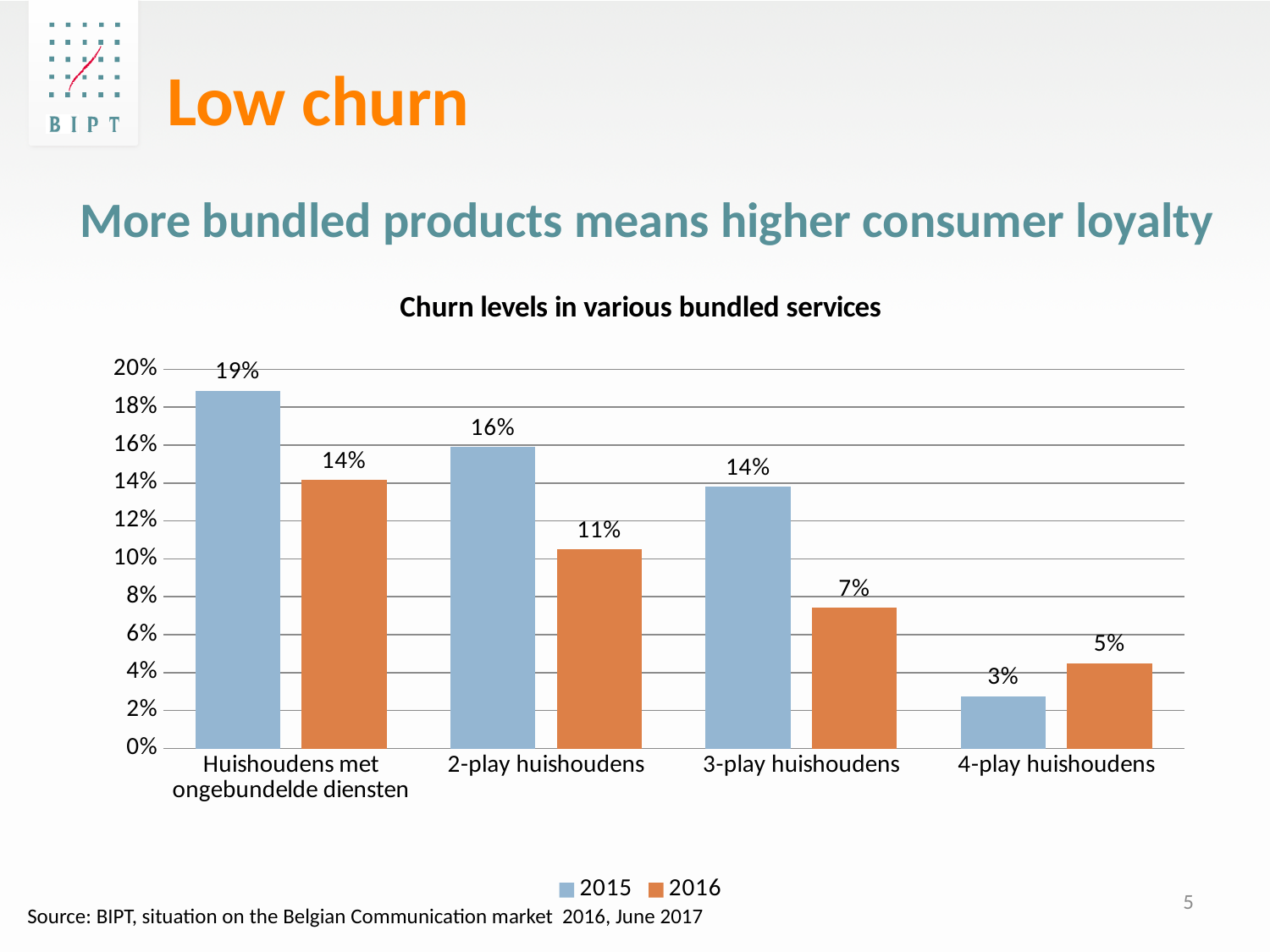
What is the 2016 churn level for 3-play huishoudens? 7% Which is larger for 4-play huishoudens: the 2015 value or the 2016 value? 2016 What is the title of the chart? Churn levels in various bundled services What kind of chart is shown on the slide? bar chart What is the 2015 churn level for 2-play huishoudens? 16% Is the 2015 value for 3-play huishoudens greater or less than 10%? greater Which category has the lowest 2016 churn level? 4-play huishoudens Which category has the highest 2015 churn level? Huishoudens met ongebundelde diensten How many series does the legend list? 2 What is the difference between the 2015 and 2016 churn levels for 2-play huishoudens? 5% What is the 2016 churn level for Huishoudens met ongebundelde diensten? 14% How many categories are shown on the x axis? 4